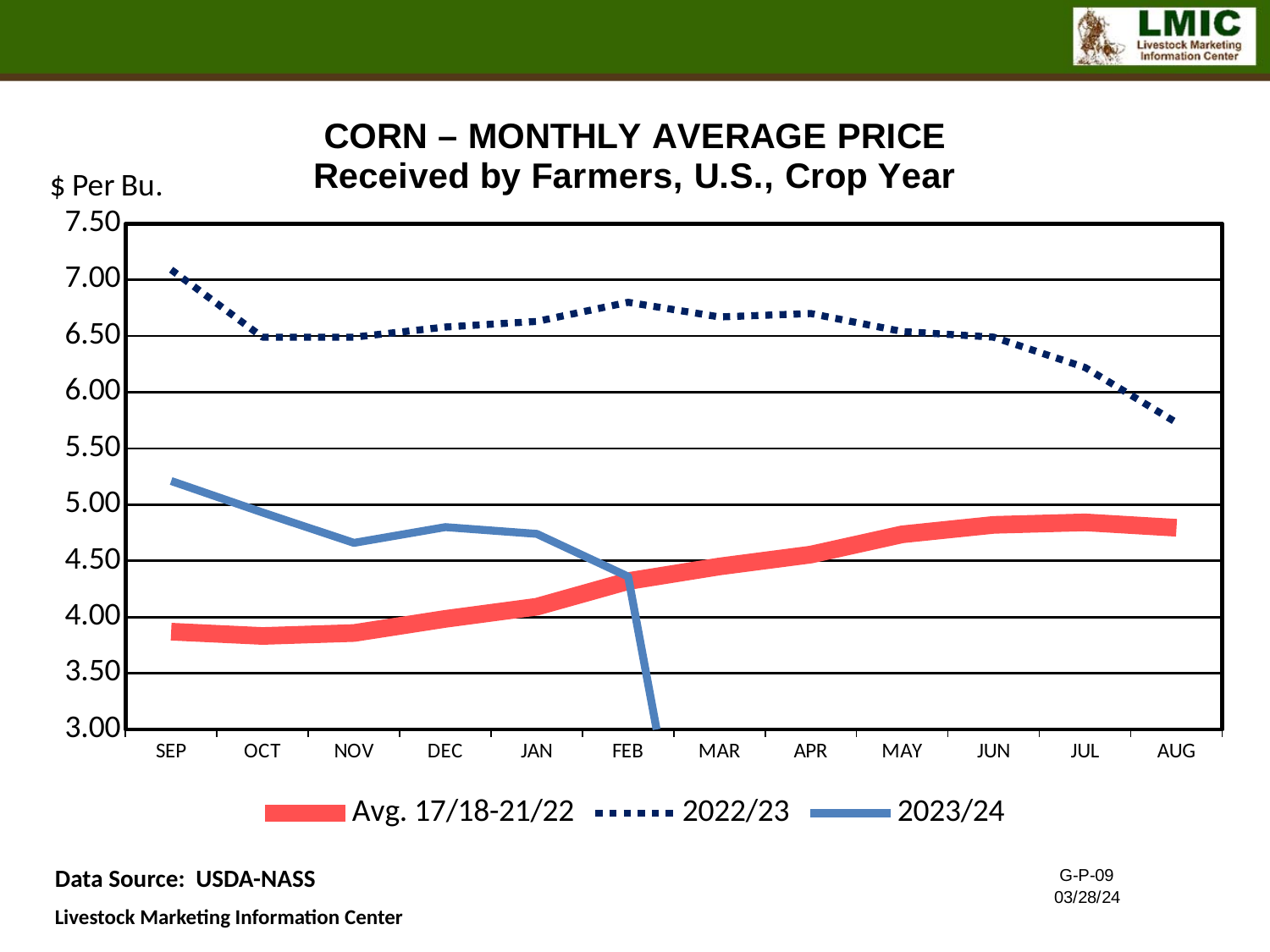
Is the 2023/24 value for SEP greater or less than 5.00? greater Is the 2022/23 value for AUG greater or less than 6.00? less What kind of chart is shown on the slide? line chart What unit is shown on the y axis? $ Per Bu. How many months are shown along the x axis? 12 Is the 2022/23 value for SEP greater or less than 6.50? greater In which month is the 2022/23 series at its highest? SEP Does the Avg. 17/18-21/22 series generally rise or fall from SEP to JUL? rise In which month is the 2022/23 series at its lowest? AUG How many series does the legend list? 3 In SEP, which series has the higher value: 2022/23 or 2023/24? 2022/23